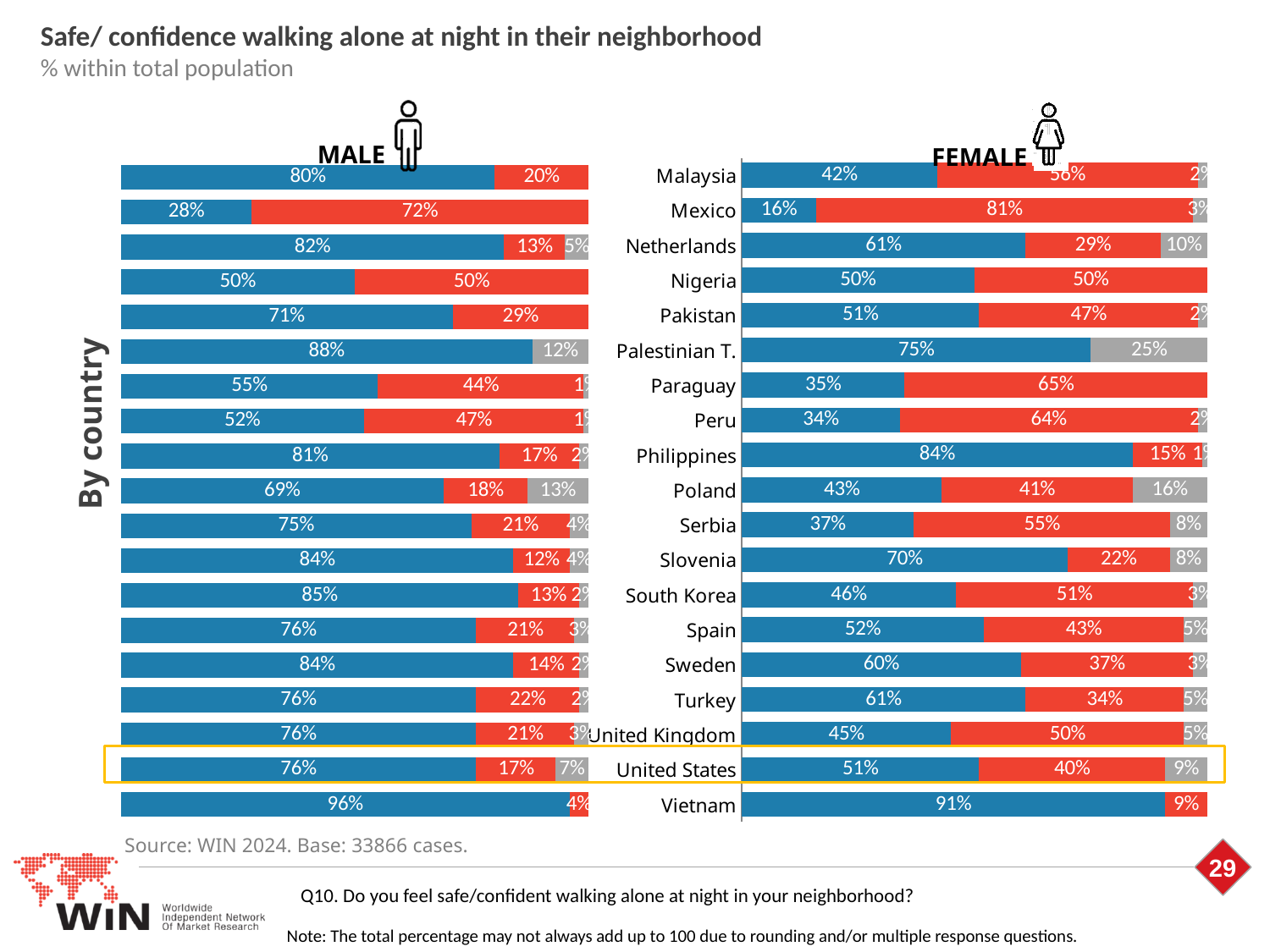
What type of chart is used on this slide? Stacked bar chart In the MALE chart, what is the value of the blue segment for Vietnam? 96% In the FEMALE chart, what is the value of the red segment for Mexico? 81% In the MALE chart, which country has the lowest blue segment value? Mexico What is the difference between the blue segment value for Vietnam in the MALE chart and in the FEMALE chart? 5% Is the blue segment value for Netherlands larger in the MALE chart or the FEMALE chart? MALE chart In the FEMALE chart, what is the value of the grey segment for Poland? 16% In the FEMALE chart, what is the difference between the blue and red segment values for Paraguay? 30% Which country's row is highlighted with a yellow outline on the slide? United States How many countries are listed on the slide? 19 In the FEMALE chart, which country has the highest blue segment value? Vietnam In the MALE chart, what is the value of the grey segment for the United States? 7%